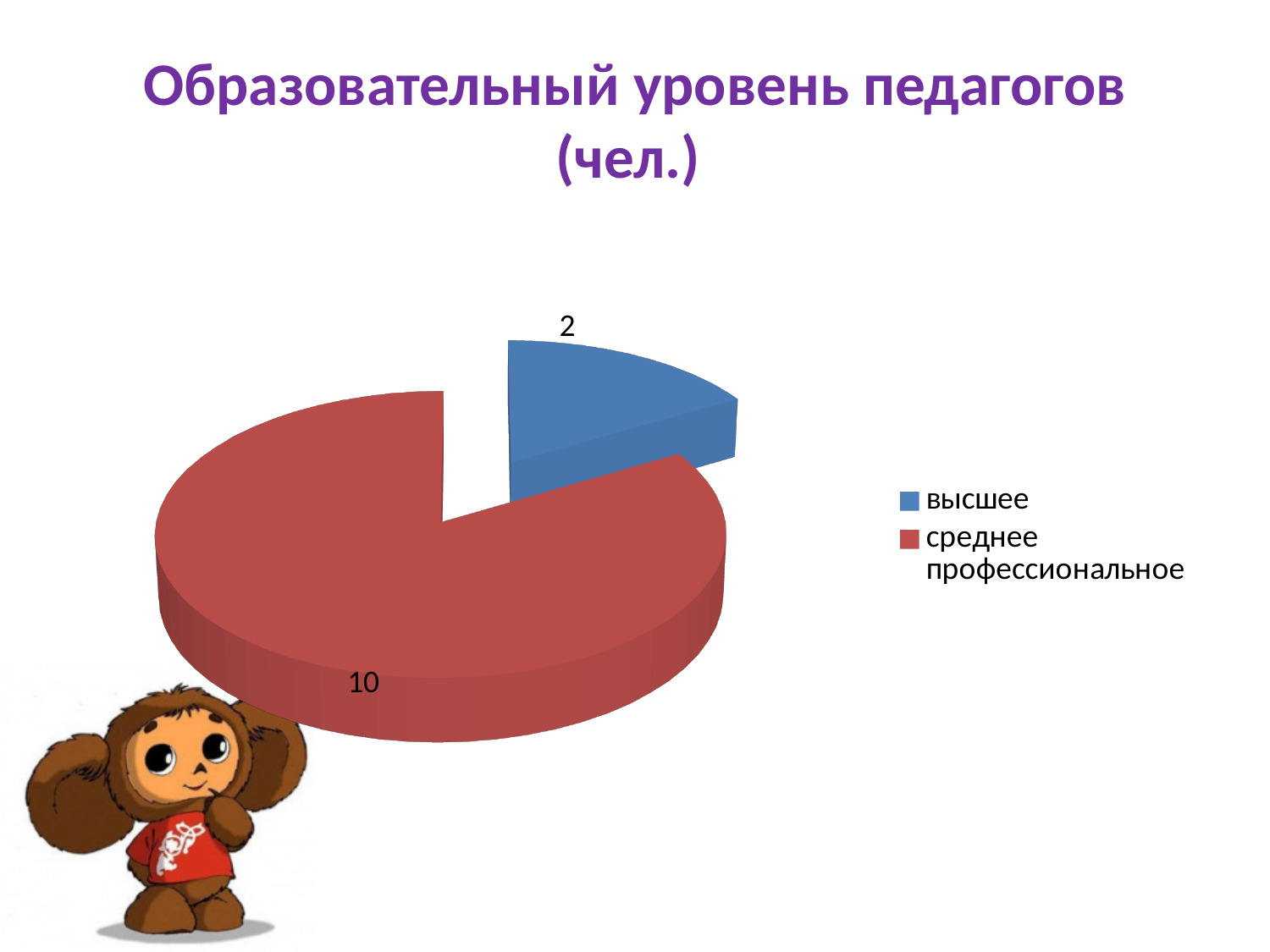
Which category has the largest slice of the pie? среднее профессиональное What is the title of the chart? Образовательный уровень педагогов (чел.) How many categories does the pie chart have? 2 What colour is the slice for высшее? blue What is the total number of teachers represented in the pie chart? 12 How many teachers have secondary vocational education (среднее профессиональное)? 10 Which category has the smallest slice of the pie? высшее What is the difference between the number of teachers with среднее профессиональное and высшее education? 8 Which is larger: the value for высшее or for среднее профессиональное? среднее профессиональное How many teachers have higher education (высшее)? 2 What type of chart is shown on the slide? pie chart